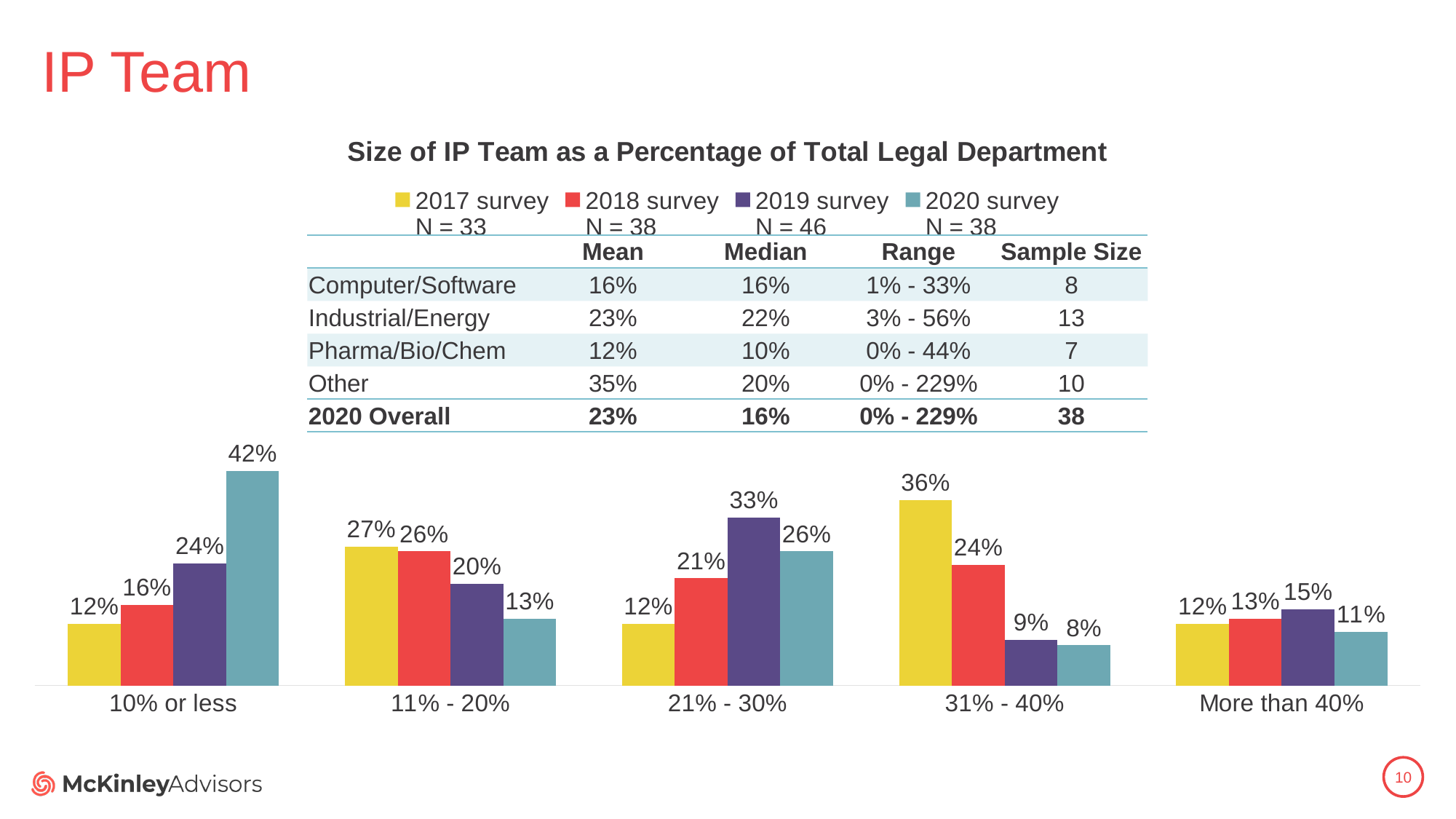
What is the value for the 2019 survey in the '21% - 30%' category? 33% In the '11% - 20%' category, which is larger: the 2017 survey value or the 2020 survey value? 2017 survey What is the value for the 2020 survey in the '10% or less' category? 42% Which category has the highest value for the 2020 survey? 10% or less What is the value for the 2017 survey in the '31% - 40%' category? 36% What is the sample size (N) for the 2019 survey shown in the legend? N = 46 How many categories are shown on the x axis of the chart? 5 What is the difference between the 2020 survey and 2017 survey values in the '10% or less' category? 30% How many series does the chart legend list? 4 What is the value for the 2018 survey in the 'More than 40%' category? 13% What kind of chart is shown on the slide? Bar chart Which category has the lowest value for the 2019 survey? 31% - 40%